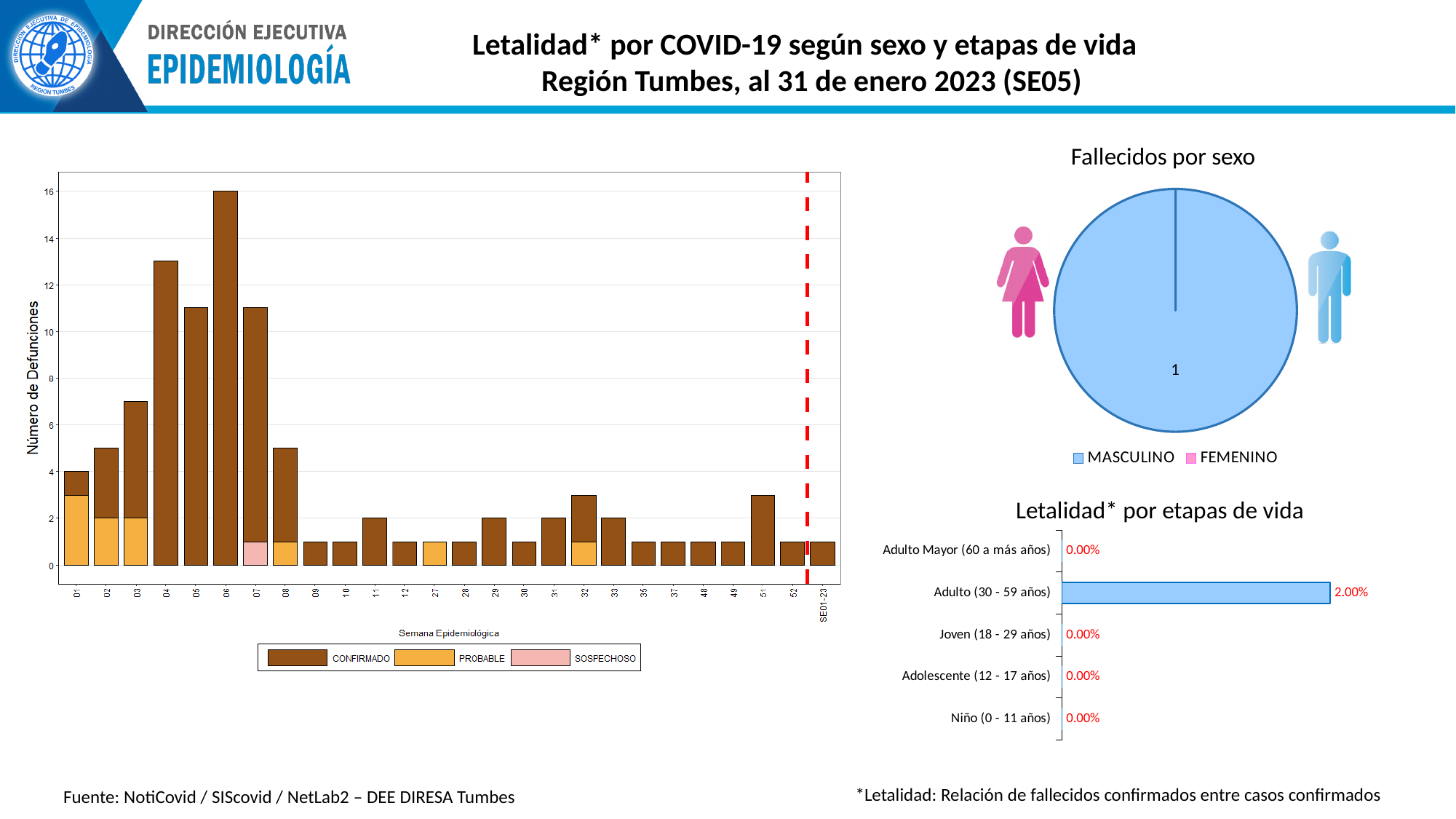
In the 'Número de Defunciones' bar chart on the left, how many deaths are shown for week 06? 16 In the 'Letalidad* por etapas de vida' chart, what is the value for Niño (0 - 11 años)? 0.00% In the 'Letalidad* por etapas de vida' chart, which age group has the highest letalidad? Adulto (30 - 59 años) How many series does the legend of the 'Fallecidos por sexo' chart list? 2 How many age-group categories are shown in the 'Letalidad* por etapas de vida' chart? 5 In the 'Letalidad* por etapas de vida' chart, what is the value for Adulto (30 - 59 años)? 2.00% In the 'Número de Defunciones' bar chart on the left, which epidemiological week has the highest number of deaths? 06 In the 'Fallecidos por sexo' pie chart, what value is labelled on the MASCULINO slice? 1 What are the legend entries of the 'Número de Defunciones' bar chart on the left? CONFIRMADO, PROBABLE, SOSPECHOSO What kind of chart is 'Letalidad* por etapas de vida'? Bar chart In the 'Número de Defunciones' bar chart on the left, is the value for week 04 greater or less than 12? greater How many series does the legend of the 'Número de Defunciones' bar chart on the left list? 3